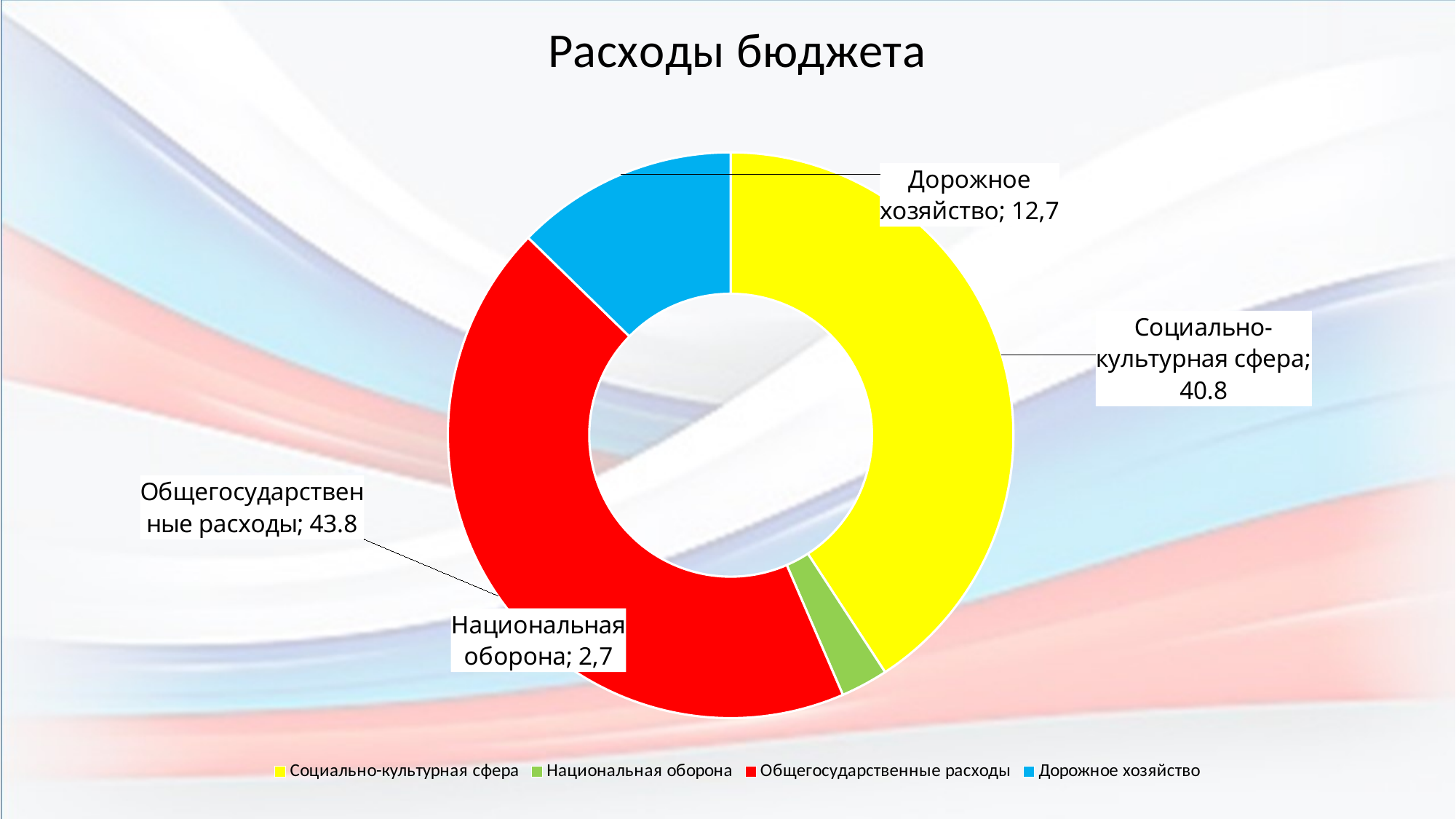
What kind of chart is shown on the slide? doughnut chart What is the value for Национальная оборона? 2,7 What is the difference between Дорожное хозяйство and Национальная оборона? 10 Which is larger, Дорожное хозяйство or Национальная оборона? Дорожное хозяйство What is the difference between Общегосударственные расходы and Социально-культурная сфера? 3.0 What is the value for Социально-культурная сфера? 40.8 Which category has the smallest value? Национальная оборона What is the value for Общегосударственные расходы? 43.8 Which category has the largest value? Общегосударственные расходы What is the value for Дорожное хозяйство? 12,7 How many categories are shown in the chart? 4 What is the title of the chart? Расходы бюджета